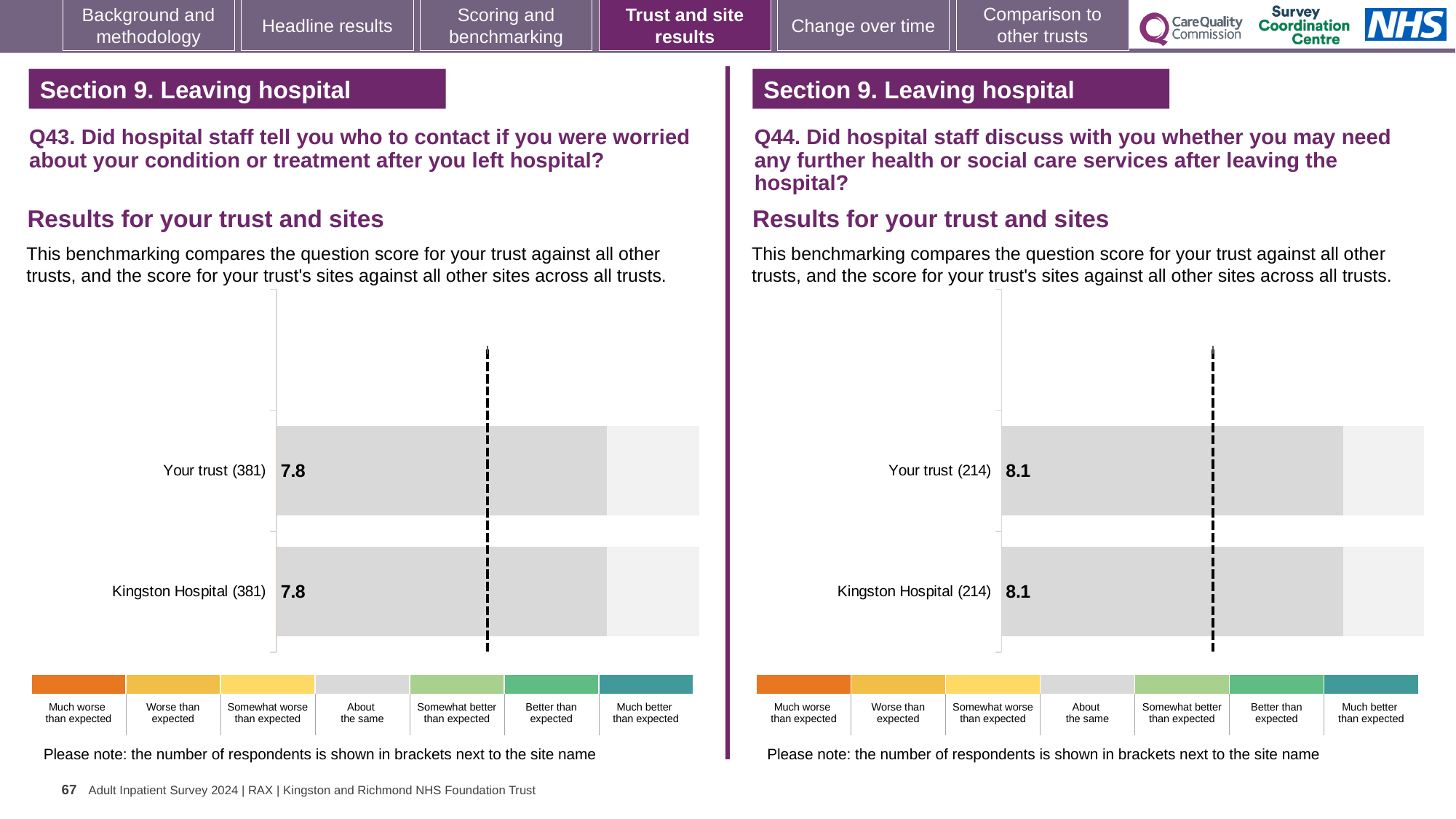
On the left chart (Q43), what is the difference between the Your trust score and the Kingston Hospital score? 0 On the left chart (Q43), what is the score for Kingston Hospital? 7.8 On the right chart (Q44), how many respondents are shown in brackets next to Your trust? 214 How many bars are plotted on the right chart (Q44)? 2 On the right chart (Q44), what is the score for Kingston Hospital? 8.1 On the right chart (Q44), what is the difference between the Your trust score and the Kingston Hospital score? 0 Is the Your trust score on the right chart (Q44) larger or smaller than the Your trust score on the left chart (Q43)? Larger What type of chart is used on the left (Q43)? Bar chart On the left chart (Q43), how many respondents are shown in brackets next to Kingston Hospital? 381 On the right chart (Q44), what is the score for Your trust? 8.1 On the left chart (Q43), what is the score for Your trust? 7.8 How many bars are plotted on the left chart (Q43)? 2